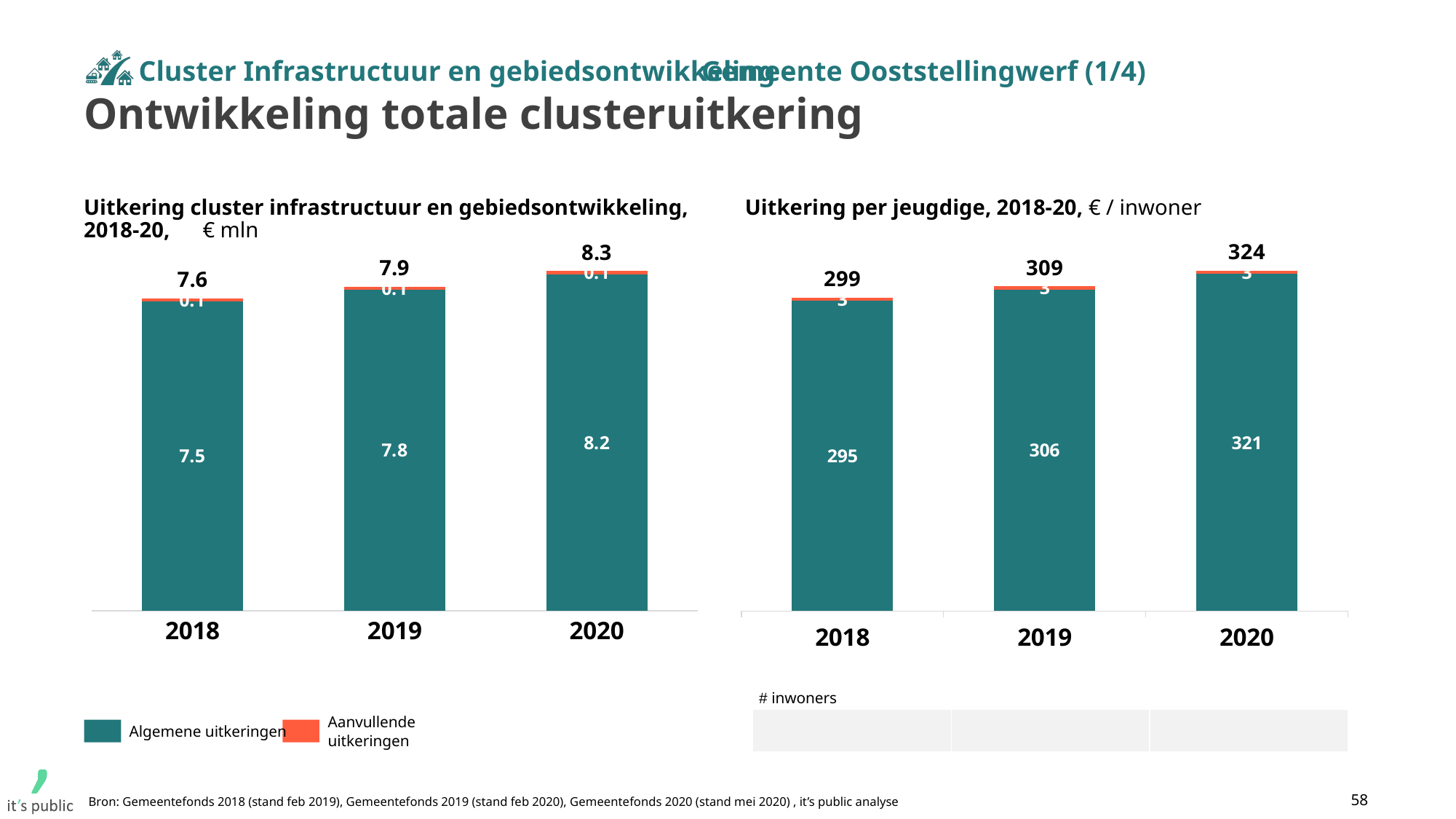
In the right chart (Uitkering per jeugdige), what is the total for 2019? 309 In the right chart (Uitkering per jeugdige), what is the value of Algemene uitkeringen for 2018? 295 How many years are shown on the x axis of the right chart (Uitkering per jeugdige)? 3 In the left chart (Uitkering cluster infrastructuur en gebiedsontwikkeling), what is the value of Algemene uitkeringen for 2019? 7.8 In the left chart (Uitkering cluster infrastructuur en gebiedsontwikkeling), what is the total of the stacked bar for 2020? 8.3 In the right chart (Uitkering per jeugdige), which year has the highest total? 2020 In the right chart (Uitkering per jeugdige), what is the difference between the Algemene uitkeringen values for 2020 and 2019? 15 What kind of chart is the left chart (Uitkering cluster infrastructuur en gebiedsontwikkeling)? stacked bar chart How many series does the legend of the left chart list? 2 In the left chart (Uitkering cluster infrastructuur en gebiedsontwikkeling), which year has the lowest total? 2018 In the left chart (Uitkering cluster infrastructuur en gebiedsontwikkeling), do the totals rise or fall from 2018 to 2020? rise In the left chart (Uitkering cluster infrastructuur en gebiedsontwikkeling), what is the difference between the 2020 total and the 2018 total? 0.7